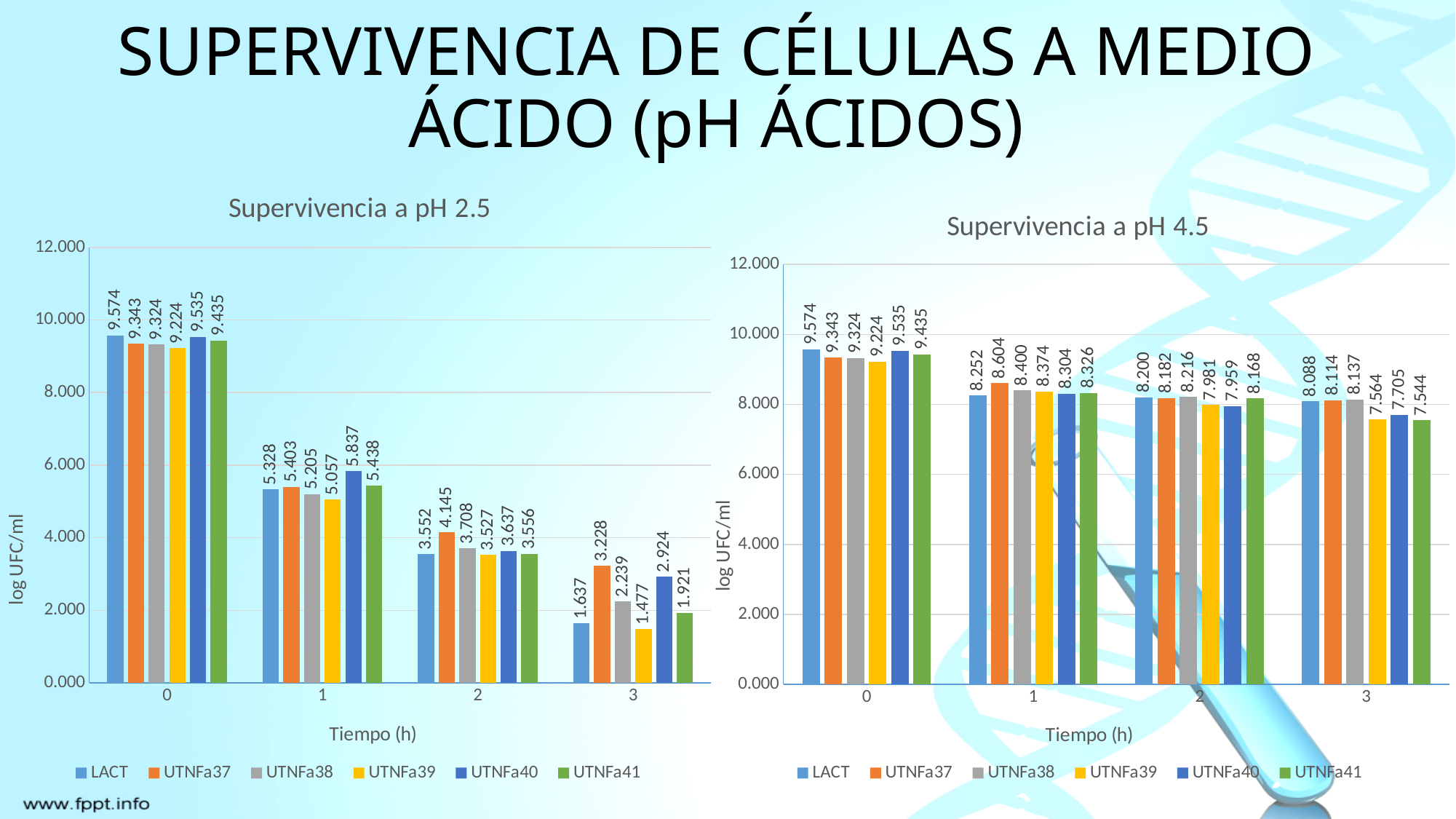
In the 'Supervivencia a pH 2.5' chart, what is the difference between the LACT values at time 0 h and time 3 h? 7.937 What is the y-axis label of the 'Supervivencia a pH 4.5' chart? log UFC/ml In the 'Supervivencia a pH 2.5' chart, what is the value for UTNFa40 at time 1 h? 5.837 In the 'Supervivencia a pH 2.5' chart, do the LACT values rise or fall as time increases from 0 h to 3 h? Fall In the 'Supervivencia a pH 2.5' chart, how many series does the legend list? 6 What kind of chart is 'Supervivencia a pH 2.5'? Bar chart In the 'Supervivencia a pH 2.5' chart, which series has the highest value at time 3 h? UTNFa37 In the 'Supervivencia a pH 2.5' chart, which series has the lowest value at time 3 h? UTNFa39 In the 'Supervivencia a pH 4.5' chart, what is the value for UTNFa37 at time 1 h? 8.604 In the 'Supervivencia a pH 4.5' chart, which series has the lowest value at time 3 h? UTNFa41 In the 'Supervivencia a pH 4.5' chart, which is larger at time 2 h: UTNFa38 or UTNFa39? UTNFa38 How many time points are shown on the x axis of the 'Supervivencia a pH 4.5' chart? 4